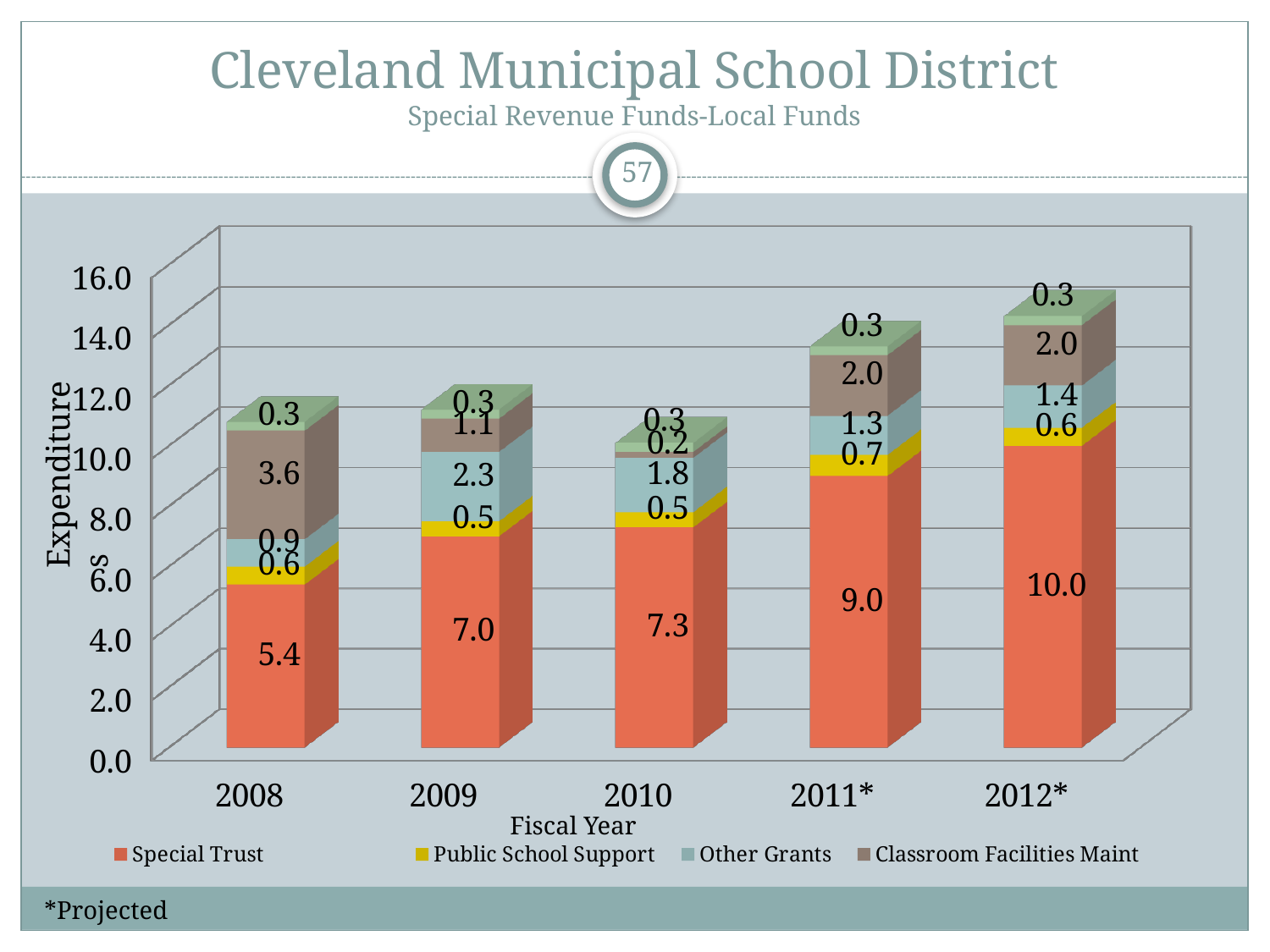
In which fiscal year is the Special Trust value lowest? 2008 What is the total of the stacked bar for fiscal year 2011*? 13.3 How many series does the legend list? 4 What is the difference between the Special Trust values for 2012* and 2008? 4.6 How many fiscal years are shown on the x axis? 5 What is the Classroom Facilities Maint value for fiscal year 2008? 3.6 What is the Special Trust value for fiscal year 2010? 7.3 Which fiscal year has the larger Other Grants value, 2009 or 2011*? 2009 In which fiscal year is the Special Trust value highest? 2012* What is the Other Grants value for fiscal year 2012*? 1.4 Does the Special Trust value rise or fall from 2008 to 2012*? Rises What kind of chart is shown on the slide? Stacked bar chart